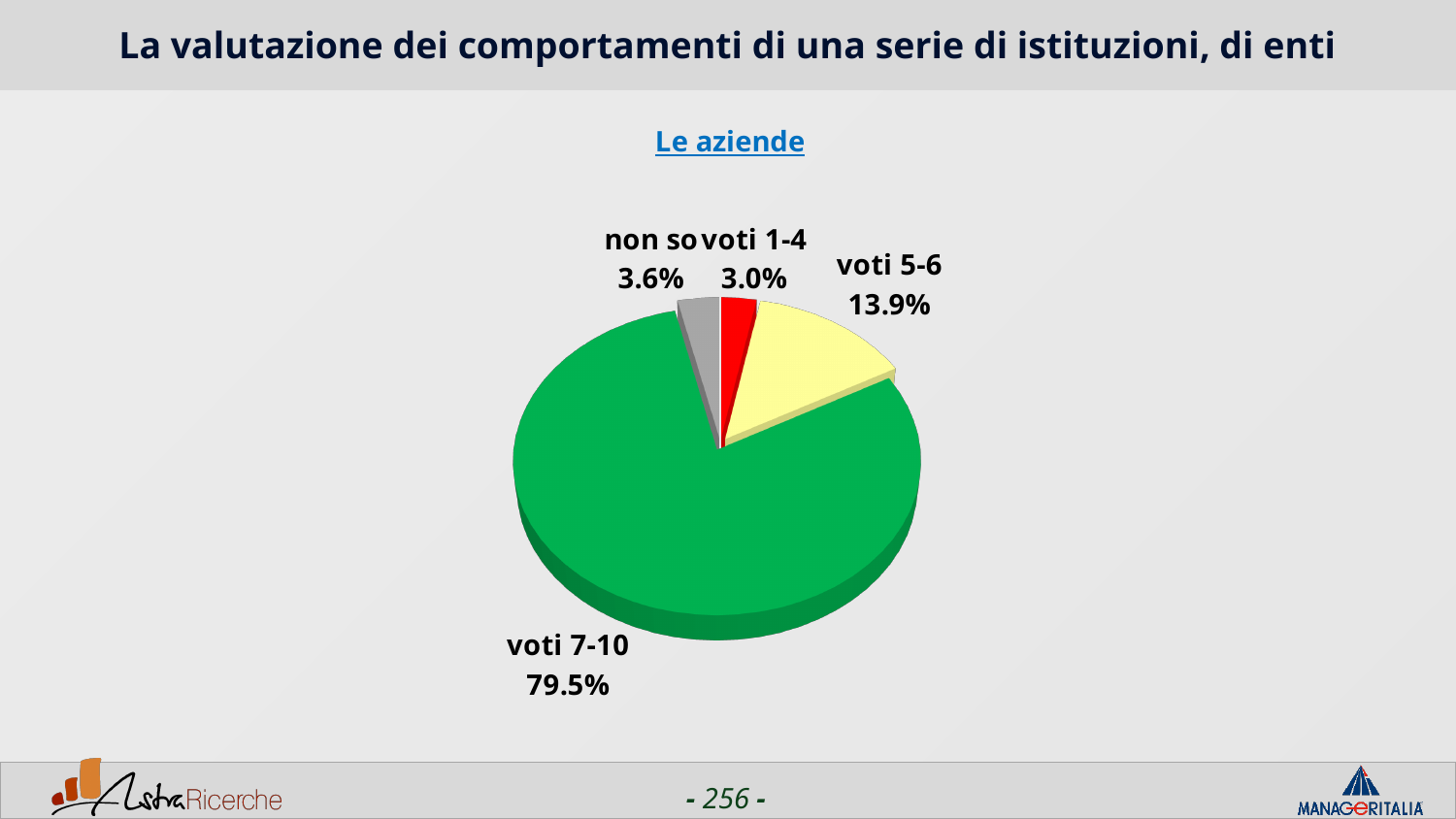
How many categories are shown in the pie chart? 4 What is the value shown for "non so"? 3.6% Which category has the smallest slice of the pie? voti 1-4 What is the value shown for "voti 5-6"? 13.9% What is the subtitle above the chart? Le aziende What share of the pie is labelled "voti 7-10"? 79.5% What is the value shown for "voti 1-4"? 3.0% What is the difference in percentage points between "non so" and "voti 1-4"? 0.6 What is the difference in percentage points between "voti 7-10" and "voti 5-6"? 65.6 Which is larger, the share for "voti 5-6" or the share for "non so"? voti 5-6 What kind of chart is shown on the slide? Pie chart Which category has the largest slice of the pie? voti 7-10